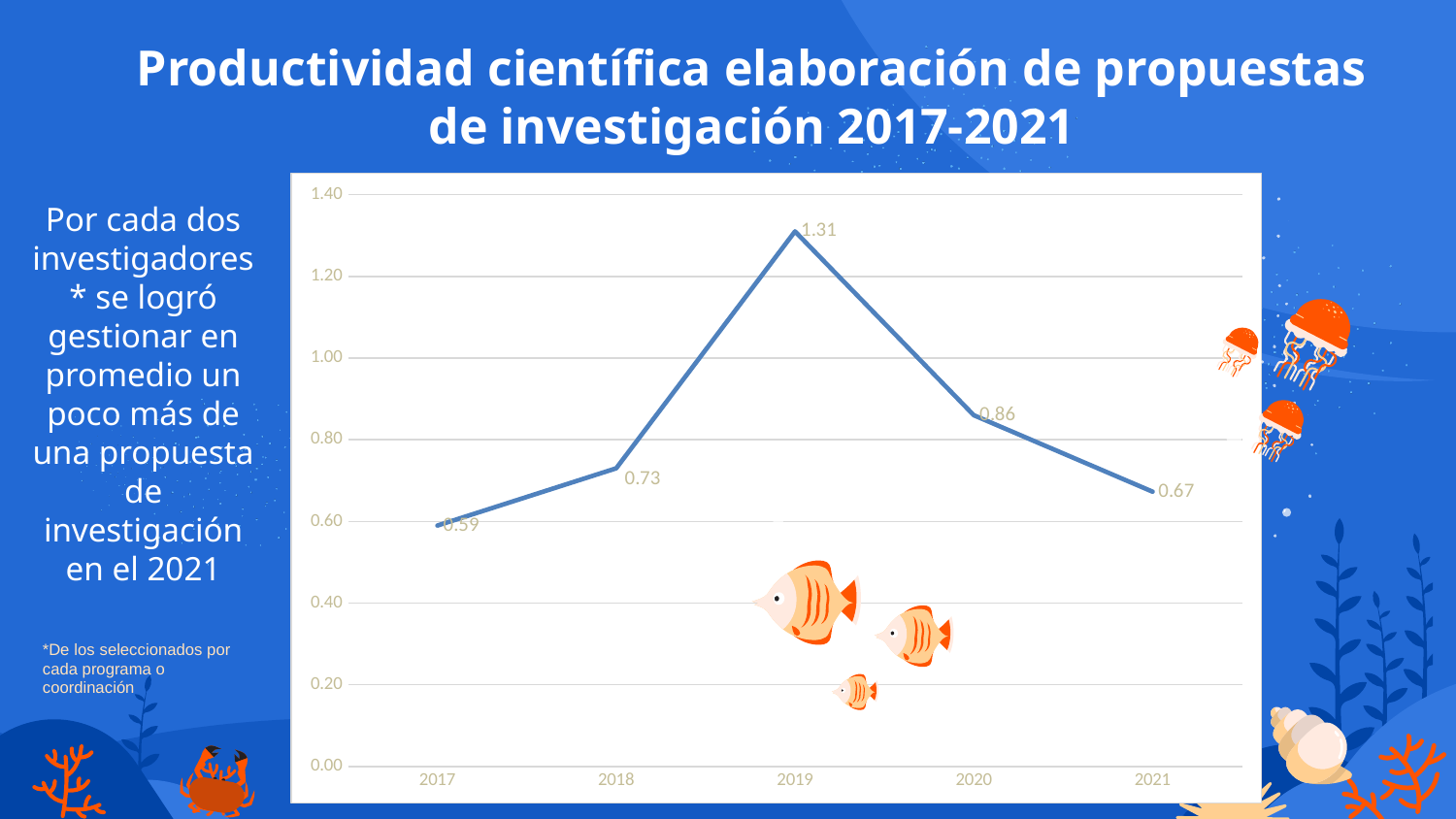
What is the value for 2019? 1.31 Which is larger, the value for 2018 or the value for 2021? 2018 Which year has the lowest value? 2017 What is the difference between the values for 2019 and 2020? 0.45 What is the value for 2021? 0.67 What type of chart is shown on the slide? line chart Which year has the highest value? 2019 Does the value rise or fall from 2019 to 2021? fall What is the value for 2020? 0.86 Is the value for 2019 greater or less than 1.20? greater How many years are plotted on the x axis? 5 What is the value for 2018? 0.73